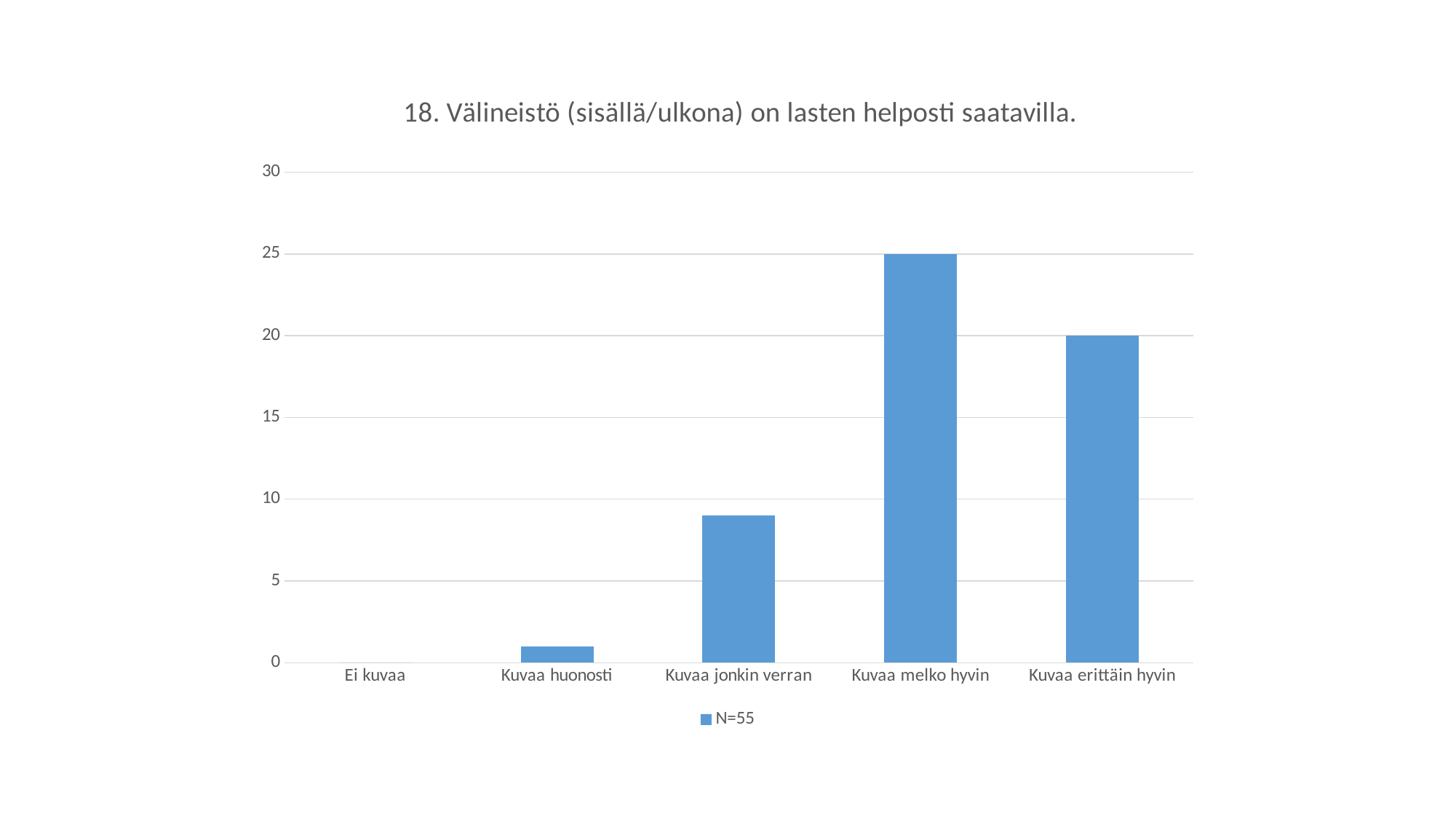
How many categories are shown on the x axis? 5 What is the difference between the values for "Kuvaa melko hyvin" and "Kuvaa erittäin hyvin"? 5 What type of chart is shown on the slide? Bar chart Which category has the highest value? Kuvaa melko hyvin What is the value for "Kuvaa melko hyvin"? 25 What is the legend entry shown below the chart? N=55 Is the value for "Kuvaa huonosti" greater or less than 5? less Is the value for "Kuvaa jonkin verran" greater or less than 10? less Which is larger, the value for "Kuvaa jonkin verran" or the value for "Kuvaa erittäin hyvin"? Kuvaa erittäin hyvin What is the value for "Kuvaa erittäin hyvin"? 20 Which category has the lowest value? Ei kuvaa How many series does the legend list? 1